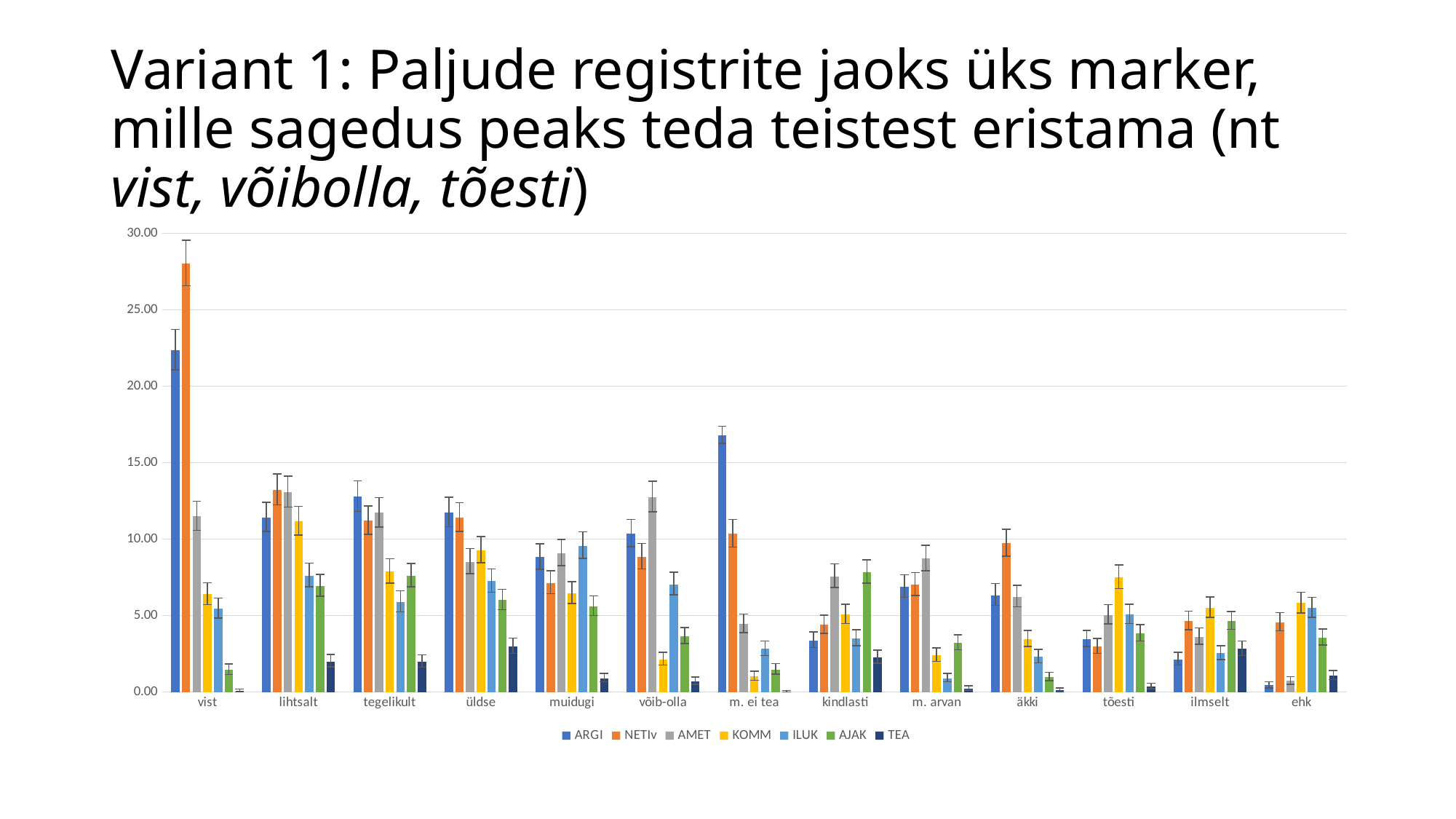
How many categories are shown on the x axis? 13 What is the last series listed in the legend? TEA What kind of chart is shown on the slide? bar chart Is the value of ARGI for m. ei tea greater or less than 15.00? greater Which series has the lowest value for the category vist? TEA Which is larger for the category äkki, ARGI or NETIv? NETIv How many series does the legend list? 7 Which series has the highest value for the category m. ei tea? ARGI Which is larger for the category kindlasti, ARGI or AJAK? AJAK Is the value of NETIv for vist greater or less than 25.00? greater Is the value of AMET for võib-olla greater or less than 10.00? greater Which series has the highest value for the category vist? NETIv